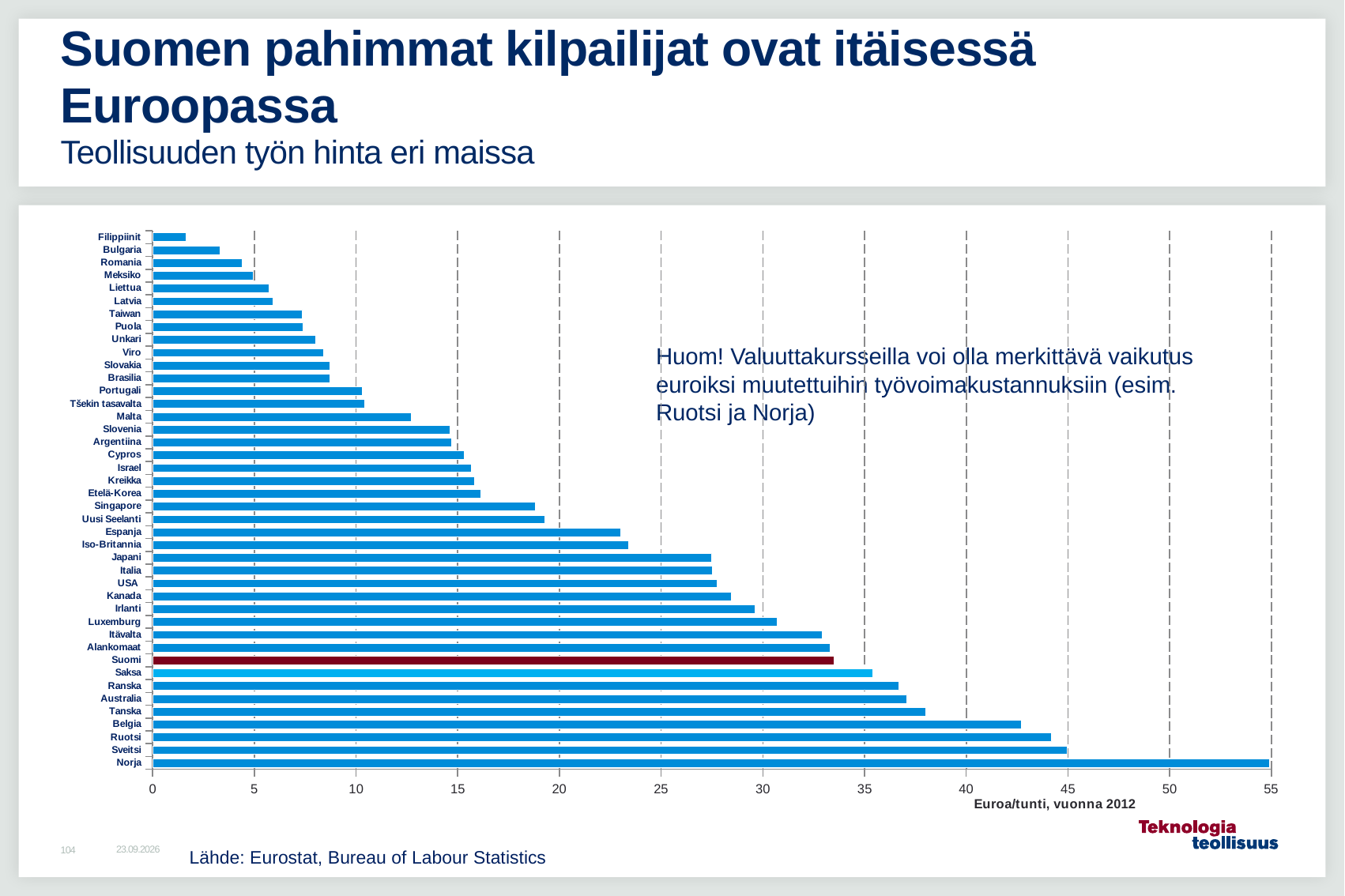
Which has a larger value, Espanja or Malta? Espanja Is the value for Filippiinit greater or less than 5? less Is the value for Belgia greater or less than 40? greater Is the value for Norja greater or less than 50? greater What kind of chart is shown on the slide? bar chart How many countries are shown in the chart? 42 Which has a larger value, Belgia or Saksa? Belgia Which country has the highest value in the chart? Norja Which country has the lowest value in the chart? Filippiinit What is the label of the horizontal axis? Euroa/tunti, vuonna 2012